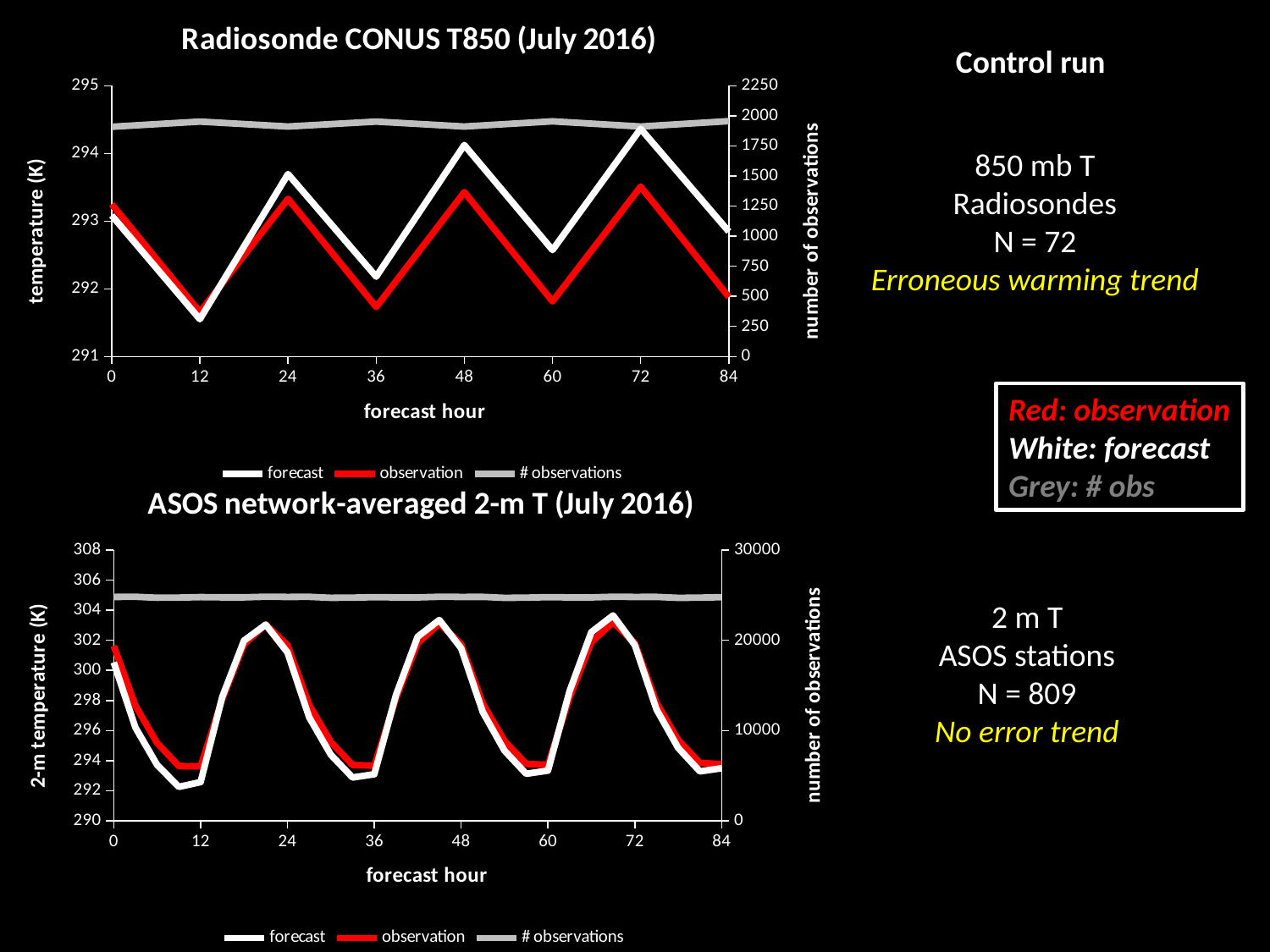
In the top chart, 'Radiosonde CONUS T850 (July 2016)', do the peaks of the forecast line rise or fall as forecast hour increases? rise In the top chart, 'Radiosonde CONUS T850 (July 2016)', is the forecast value at forecast hour 12 greater or less than 292? less In the bottom chart, 'ASOS network-averaged 2-m T (July 2016)', is the forecast value at forecast hour 12 greater or less than 294? less In the top chart, 'Radiosonde CONUS T850 (July 2016)', which is larger: the forecast value at forecast hour 0 or at forecast hour 72? forecast hour 72 What is the title of the bottom chart on the slide? ASOS network-averaged 2-m T (July 2016) What kind of chart is the top chart, 'Radiosonde CONUS T850 (July 2016)'? line chart In the top chart, 'Radiosonde CONUS T850 (July 2016)', is the number of observations greater or less than 1750 throughout the forecast period? greater What is the label of the left vertical axis of the top chart, 'Radiosonde CONUS T850 (July 2016)'? temperature (K) How many series does the legend of the top chart, 'Radiosonde CONUS T850 (July 2016)', list? 3